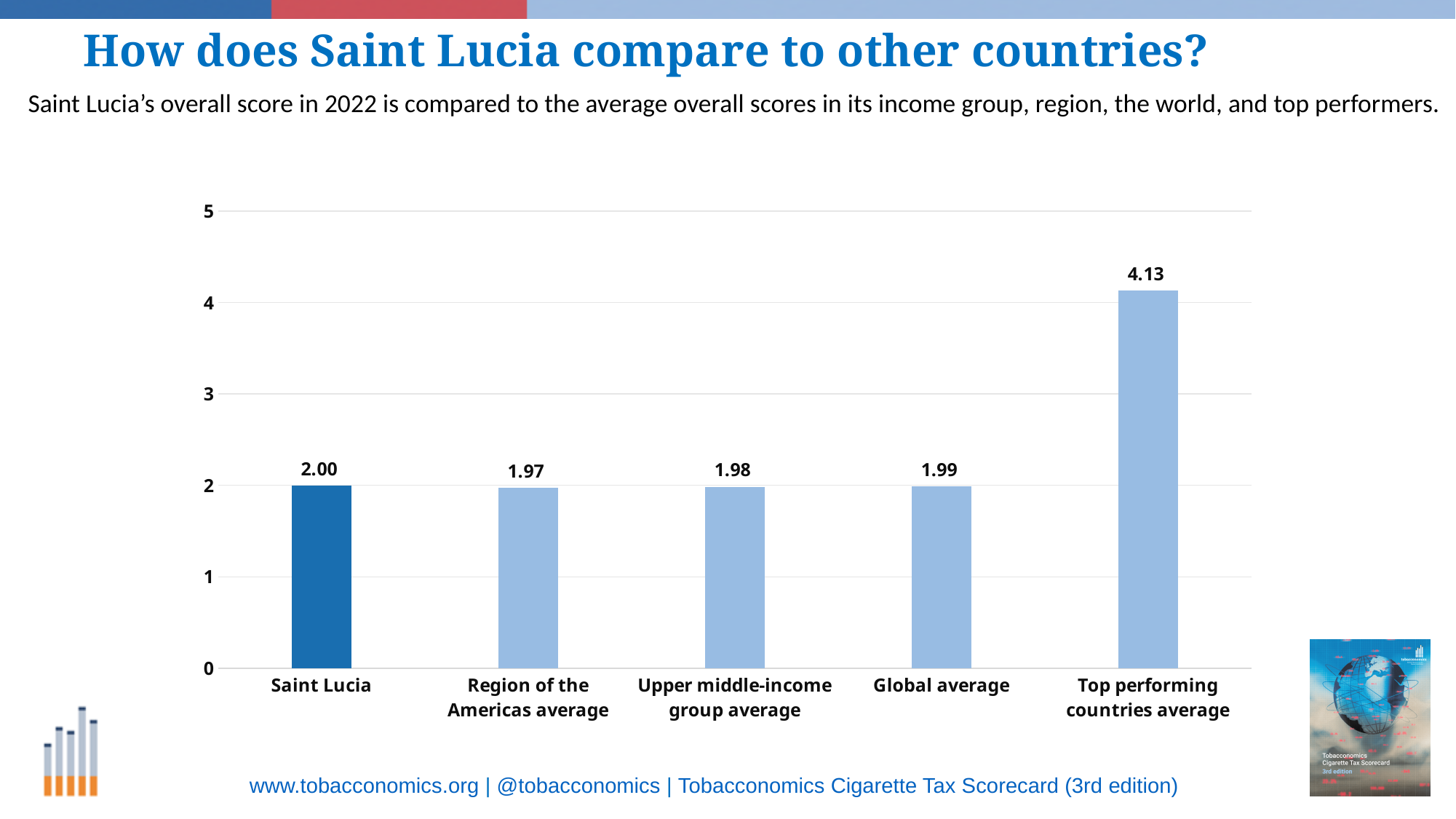
What is the value for the Global average? 1.99 Which category has the highest value? Top performing countries average What kind of chart is shown on the slide? Bar chart What is the difference between Saint Lucia and the Region of the Americas average? 0.03 What is the value for the Region of the Americas average? 1.97 Is the value for the Top performing countries average greater or less than 4? greater What is the value for Saint Lucia? 2.00 What is the difference between the Top performing countries average and Saint Lucia? 2.13 What is the value for the Upper middle-income group average? 1.98 How many categories are shown on the chart? 5 Which bar is shown in a darker blue than the others? Saint Lucia What is the value for the Top performing countries average? 4.13